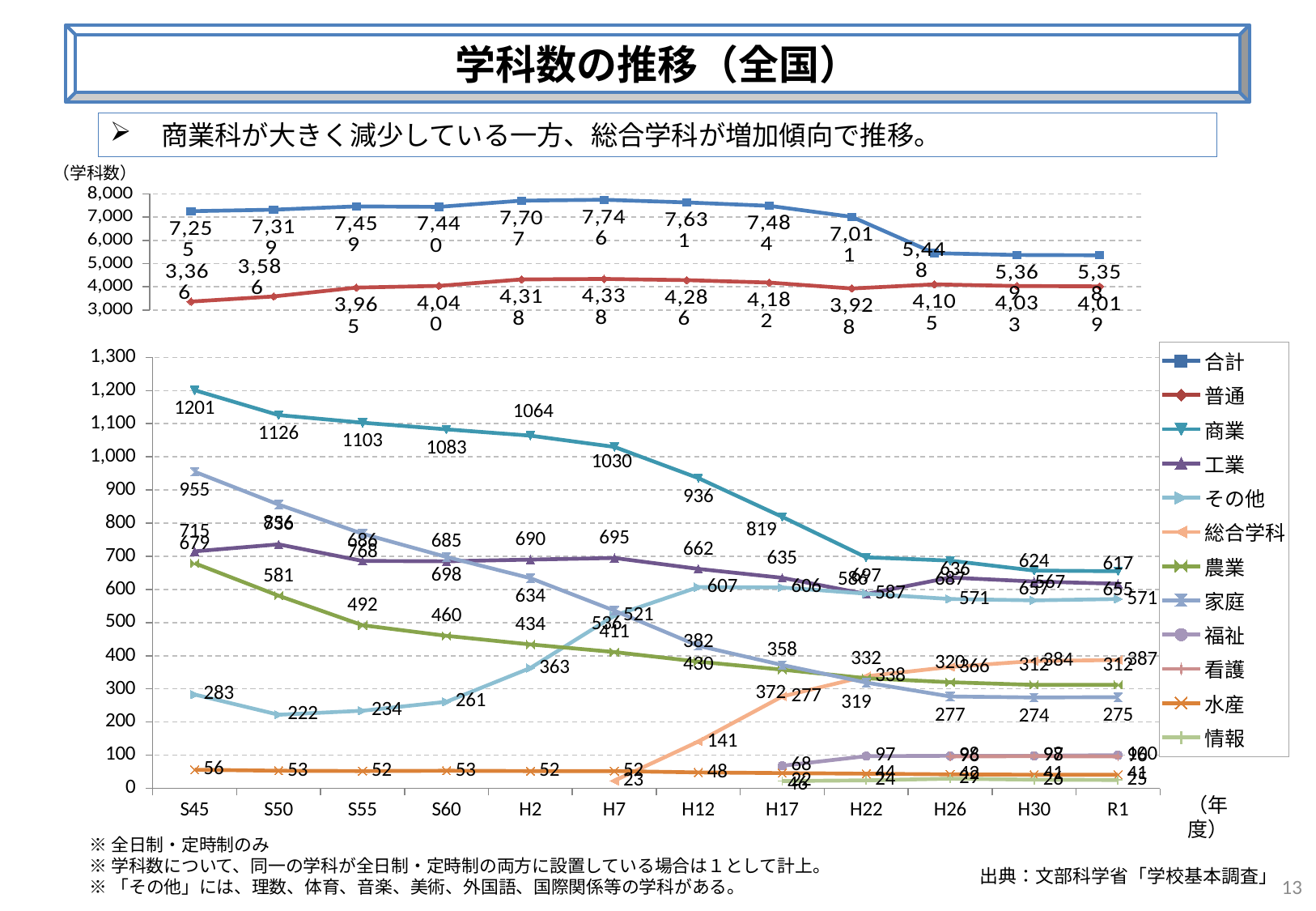
In the top chart, in which year is 合計 highest? H7 In the bottom chart, which is larger at S45, 商業 or 工業? 商業 In the top chart, what is the value of 合計 for H7? 7,746 How many year categories are shown on the x axis of the bottom chart? 12 In the bottom chart, what is the value of 商業 for S45? 1201 In the top chart, what is the value of 合計 for R1? 5,358 In the bottom chart, what is the value of 総合学科 for R1? 387 How many series does the legend of the bottom chart list? 12 In the top chart, what is the value of 普通 for S45? 3,366 What kind of chart is the bottom chart? line chart In the bottom chart, does 商業 rise or fall from S45 to R1? fall In the bottom chart, what is the difference between the 商業 values for S45 and R1? 546